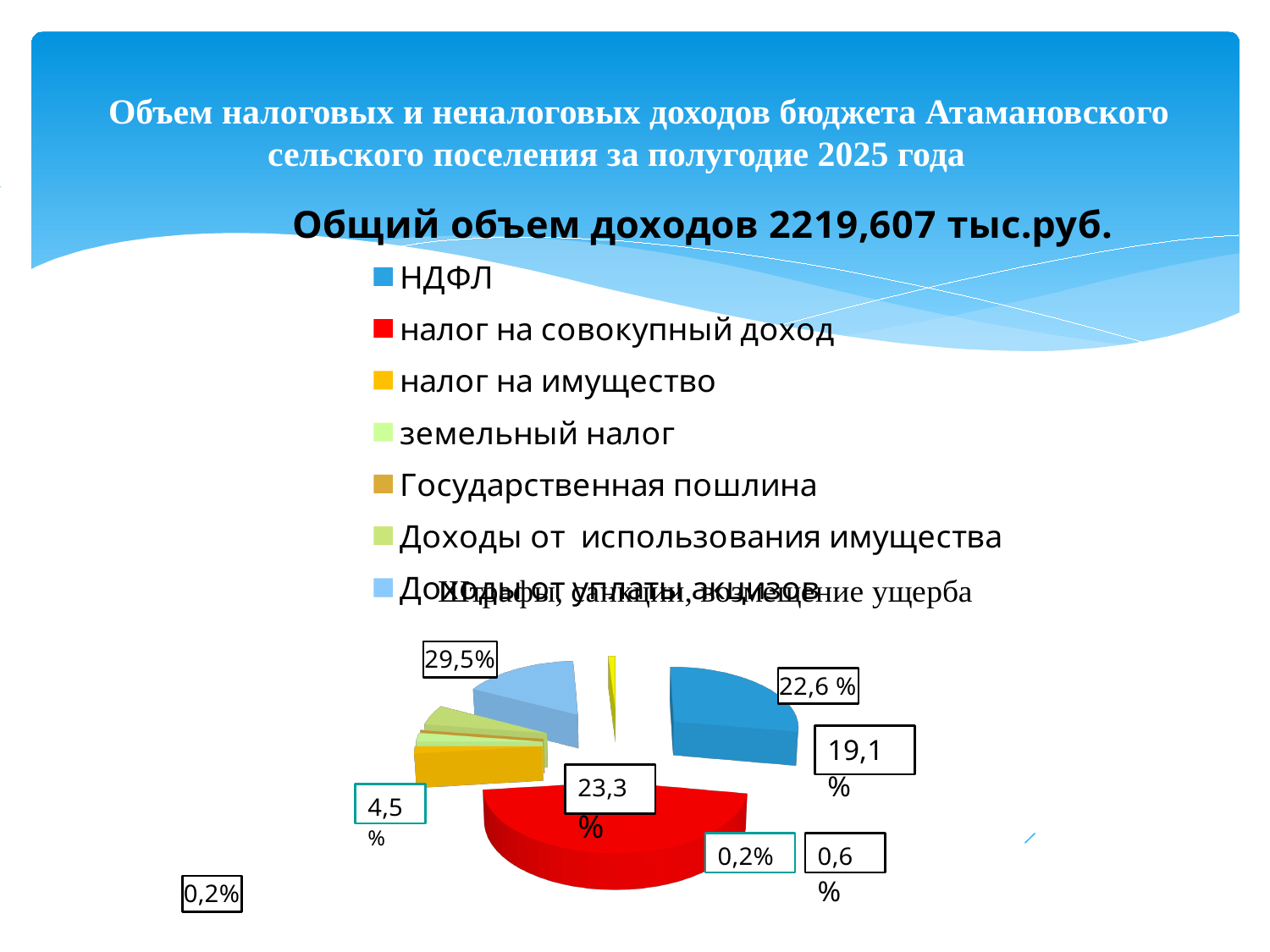
What share of the pie is labelled for Доходы от уплаты акцизов? 29,5% Which is larger, the share for НДФЛ or the share for налог на имущество? НДФЛ What share of the pie is labelled for НДФЛ? 22,6 % Which colour represents налог на совокупный доход in the legend? red Which is larger, the share for Доходы от уплаты акцизов or the share for налог на имущество? Доходы от уплаты акцизов What kind of chart is shown on the slide? pie chart Is the share for налог на имущество greater or less than 10%? less What is the title of the chart? Общий объем доходов 2219,607 тыс.руб.